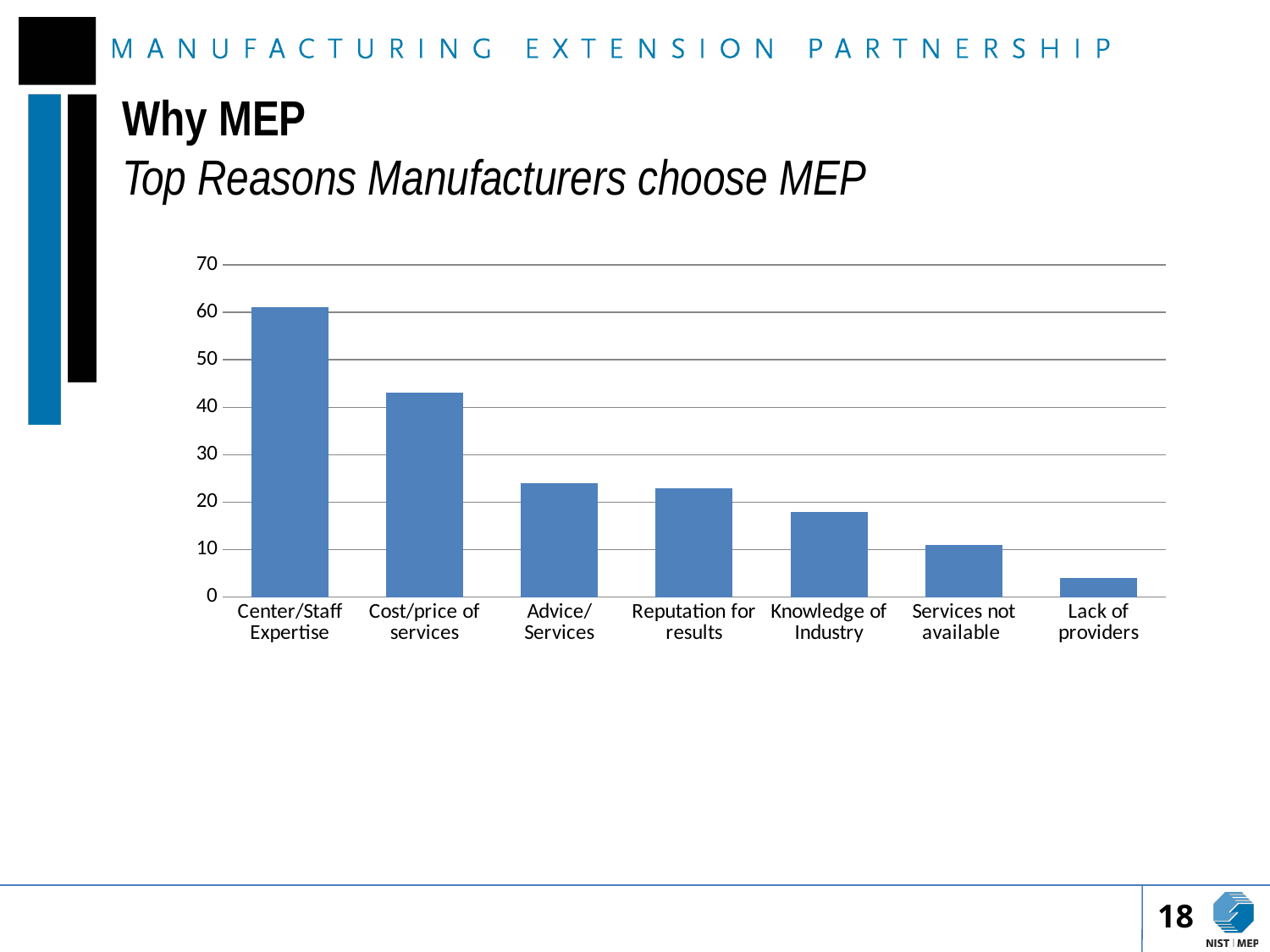
Which is larger, the value for Cost/price of services or the value for Advice/Services? Cost/price of services How many categories are shown on the x axis of the chart? 7 What is the subtitle of the slide describing the chart? Top Reasons Manufacturers choose MEP Is the value for Lack of providers greater or less than 10? less Which category has the lowest value in the chart? Lack of providers What kind of chart is shown on the slide? bar chart Which category has the highest value in the chart? Center/Staff Expertise Is the value for Knowledge of Industry greater or less than 20? less Is the value for Cost/price of services greater or less than 40? greater Do the bar values rise or fall moving from left to right along the x axis? fall